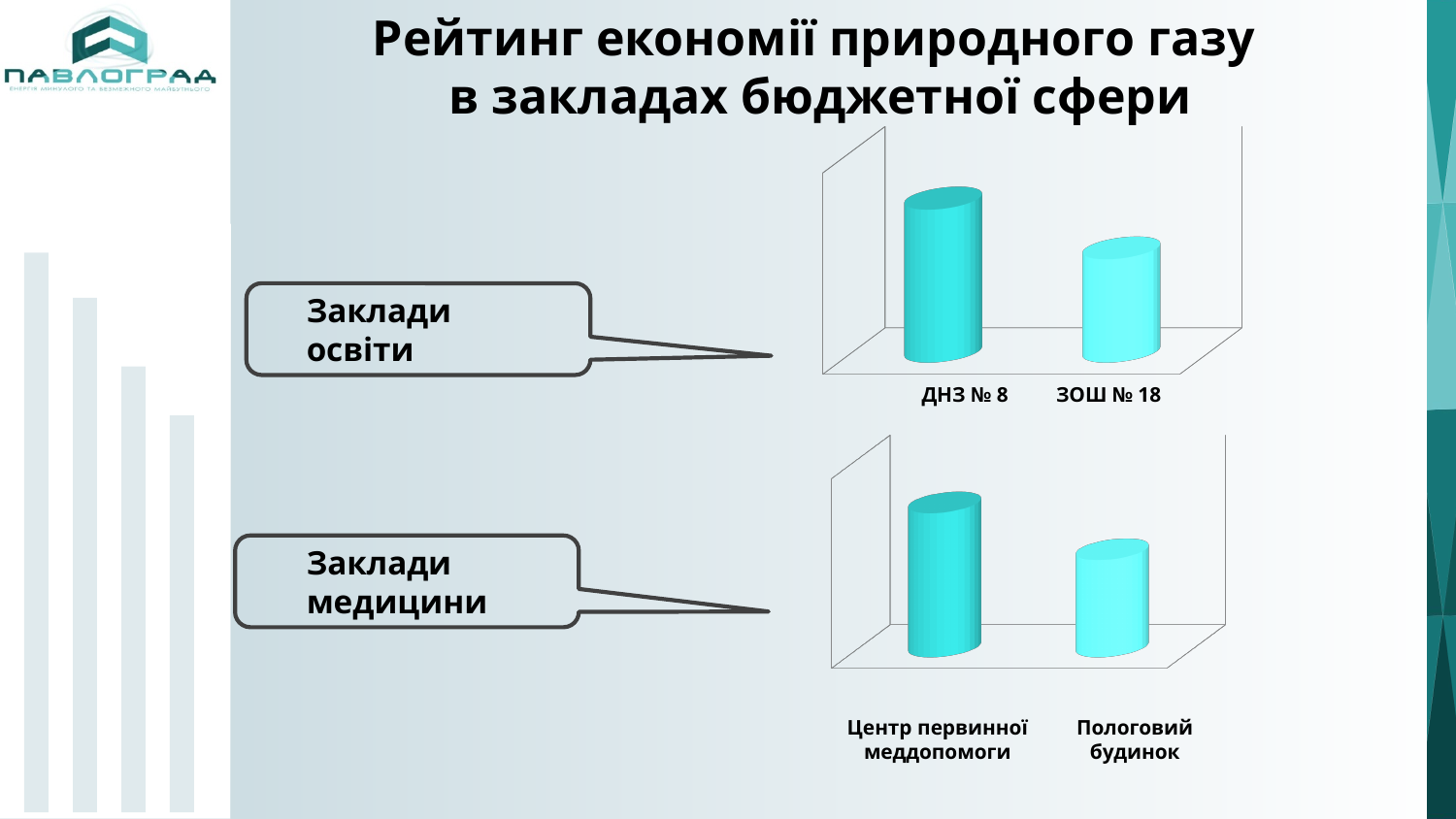
In the top chart (Заклади освіти), which is larger: the bar for ДНЗ № 8 or the bar for ЗОШ № 18? ДНЗ № 8 In the bottom chart (Заклади медицини), which is larger: the bar for Центр первинної меддопомоги or the bar for Пологовий будинок? Центр первинної меддопомоги How many categories are shown in the bottom chart (Заклади медицини)? 2 How many categories are shown in the top chart (Заклади освіти)? 2 What kind of chart is the bottom chart (Заклади медицини)? Bar chart How many charts are shown on the slide? 2 In the top chart (Заклади освіти), which category has the shortest bar? ЗОШ № 18 In the bottom chart (Заклади медицини), which category has the tallest bar? Центр первинної меддопомоги In the top chart (Заклади освіти), which category has the tallest bar? ДНЗ № 8 What kind of chart is the top chart (Заклади освіти)? Bar chart What is the title of the slide containing the two charts? Рейтинг економії природного газу в закладах бюджетної сфери In the bottom chart (Заклади медицини), which category has the shortest bar? Пологовий будинок